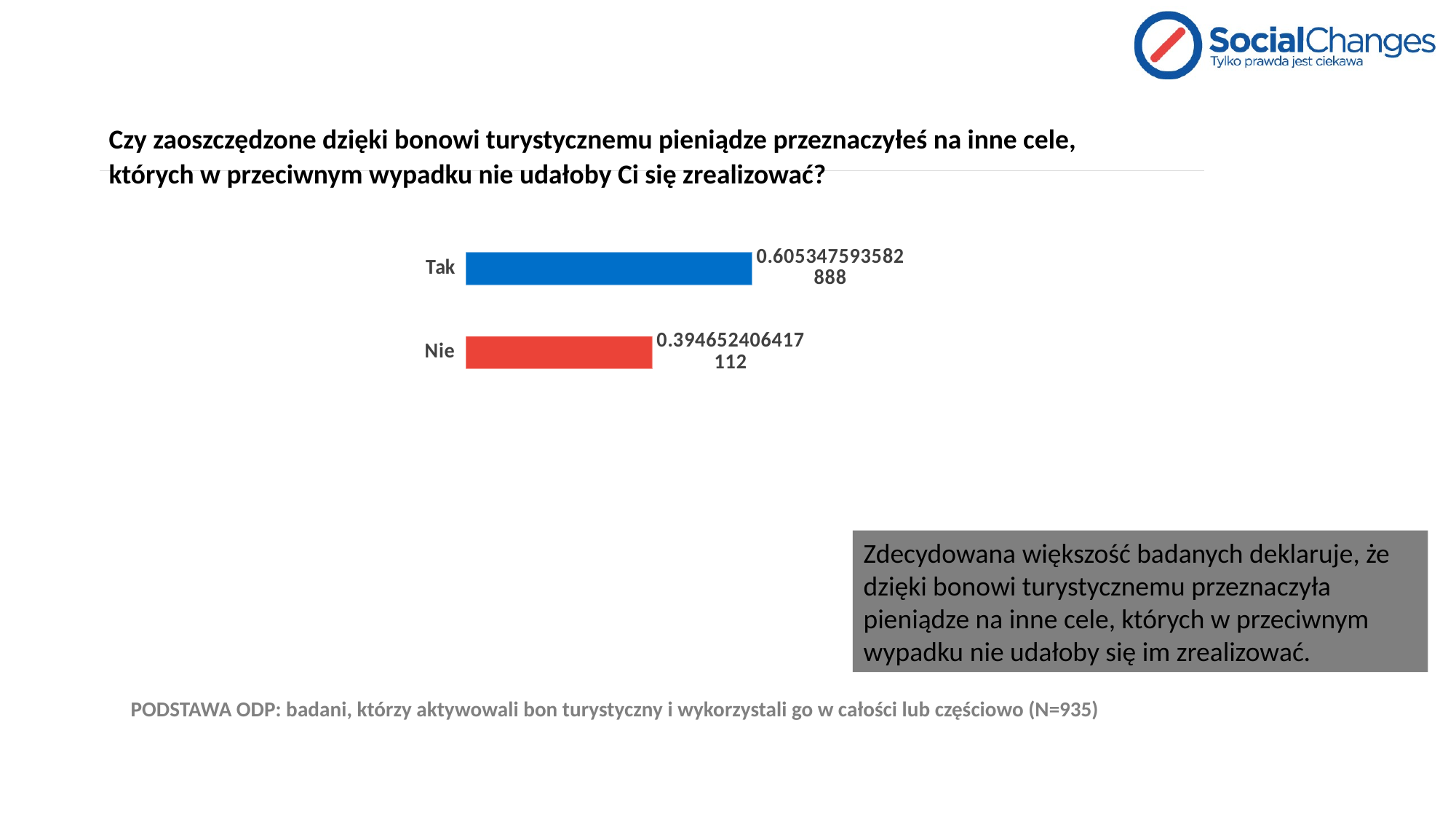
What is the difference between the value for "Tak" and the value for "Nie"? 0.210695187165776 Which is larger, the value for "Tak" or the value for "Nie"? Tak What colour is the bar for "Nie"? Red What is the value shown for "Tak"? 0.605347593582888 How many categories are shown in the chart? 2 What colour is the bar for "Tak"? Blue What is the value shown for "Nie"? 0.394652406417112 Which category has the highest value? Tak What kind of chart is shown on the slide? Bar chart Which category has the lowest value? Nie